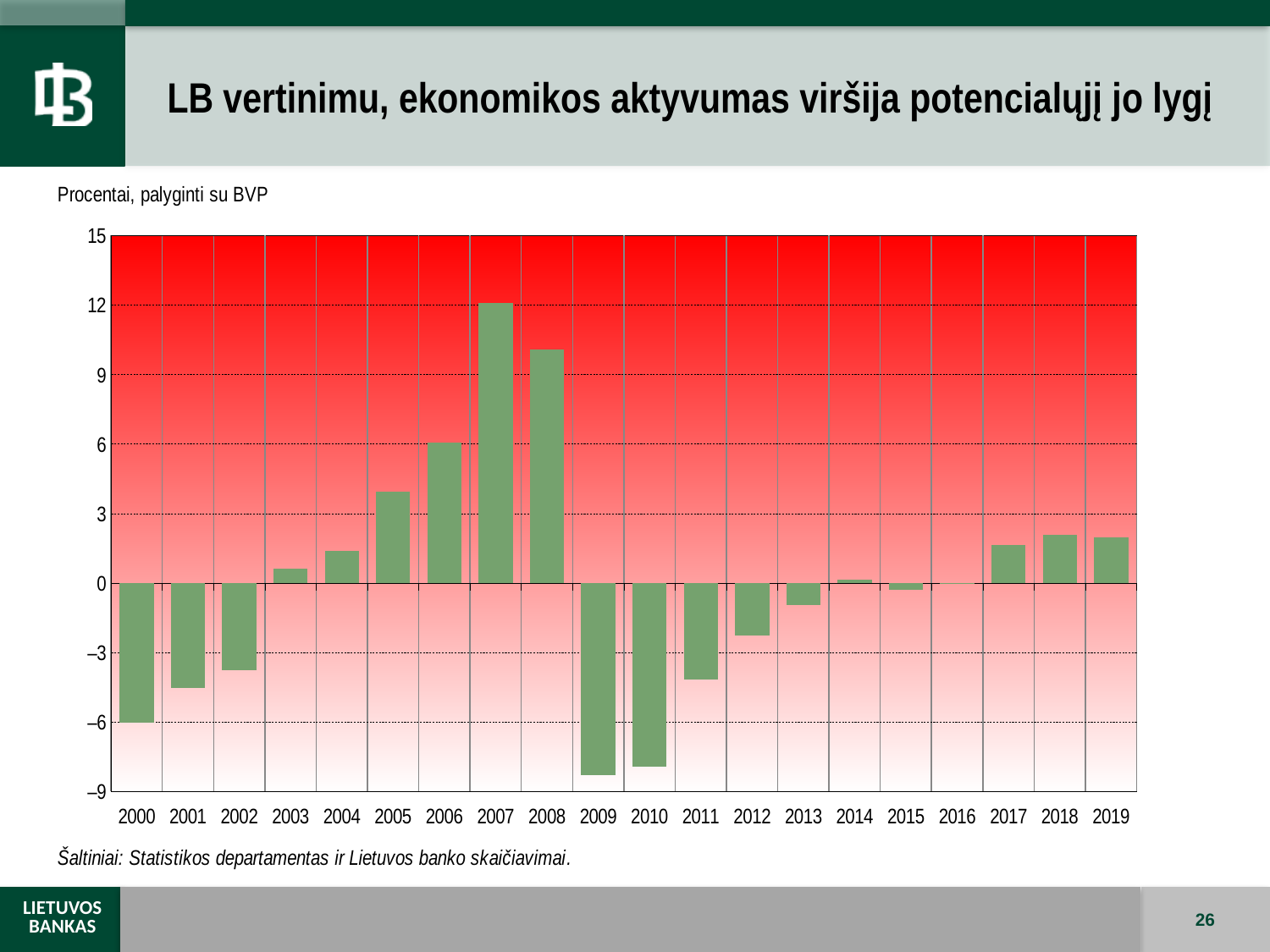
What is the subtitle printed above the chart? Procentai, palyginti su BVP How many years are shown on the x axis of the chart? 20 Which is larger, the value for 2005 or the value for 2006? 2006 Do the values rise or fall from 2003 to 2007? rise Is the value for 2009 greater or less than -6? less Which year has the highest value in the chart? 2007 Which is larger, the value for 2007 or the value for 2008? 2007 Is the value for 2007 greater or less than 9? greater Is the value for 2000 greater or less than -3? less What kind of chart is shown on the slide? bar chart